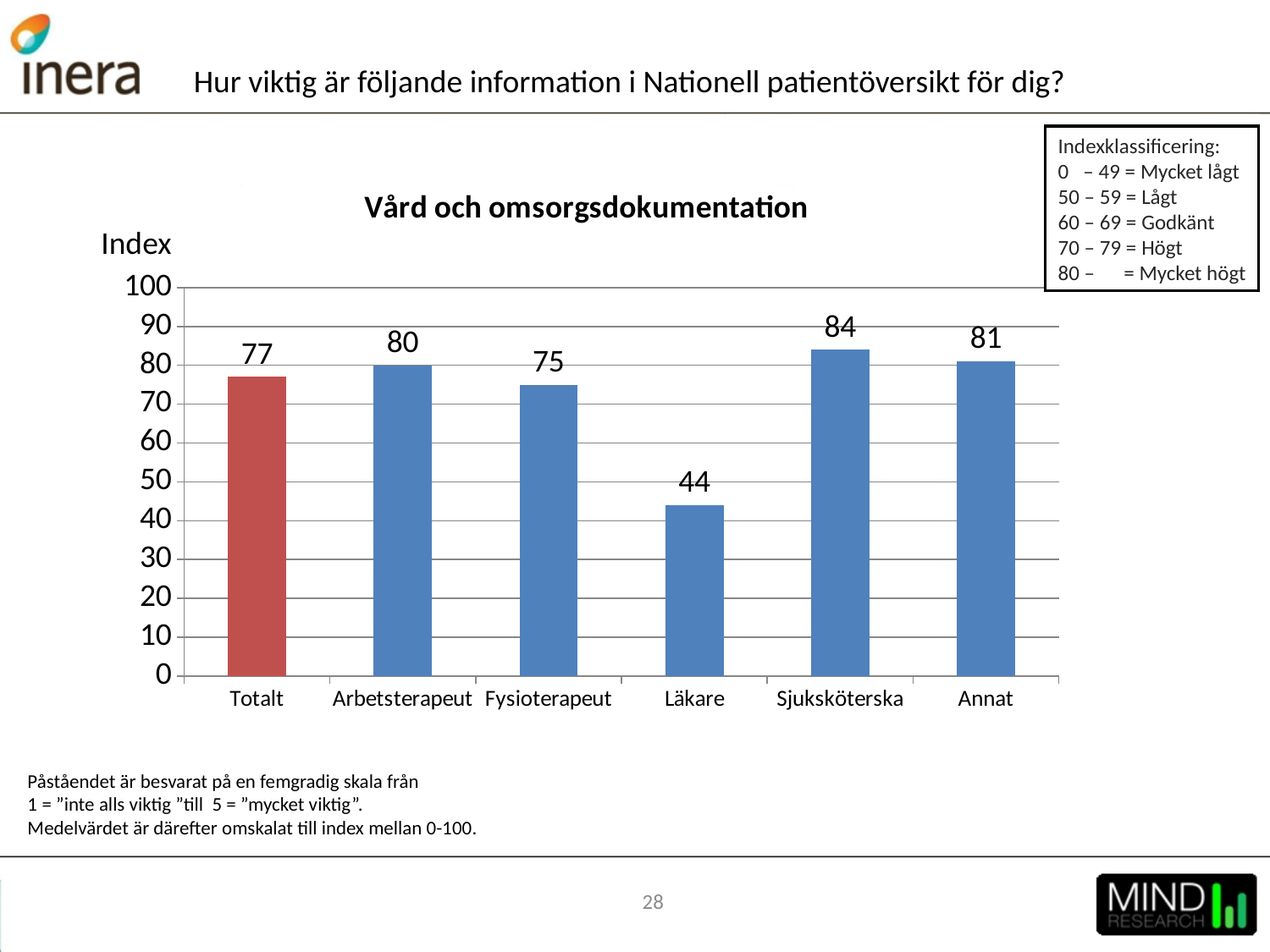
What is the index value for Totalt? 77 What is the title of the chart? Vård och omsorgsdokumentation Which category has the lowest index value? Läkare What is the difference between the index values for Sjuksköterska and Läkare? 40 What is the index value for Läkare? 44 Which category has the highest index value? Sjuksköterska Which has a higher index value, Annat or Fysioterapeut? Annat Is the value for Läkare greater or less than 50? less What kind of chart is shown on the slide? bar chart What is the index value for Sjuksköterska? 84 What is the difference between the index values for Arbetsterapeut and Fysioterapeut? 5 How many categories are shown on the x axis? 6